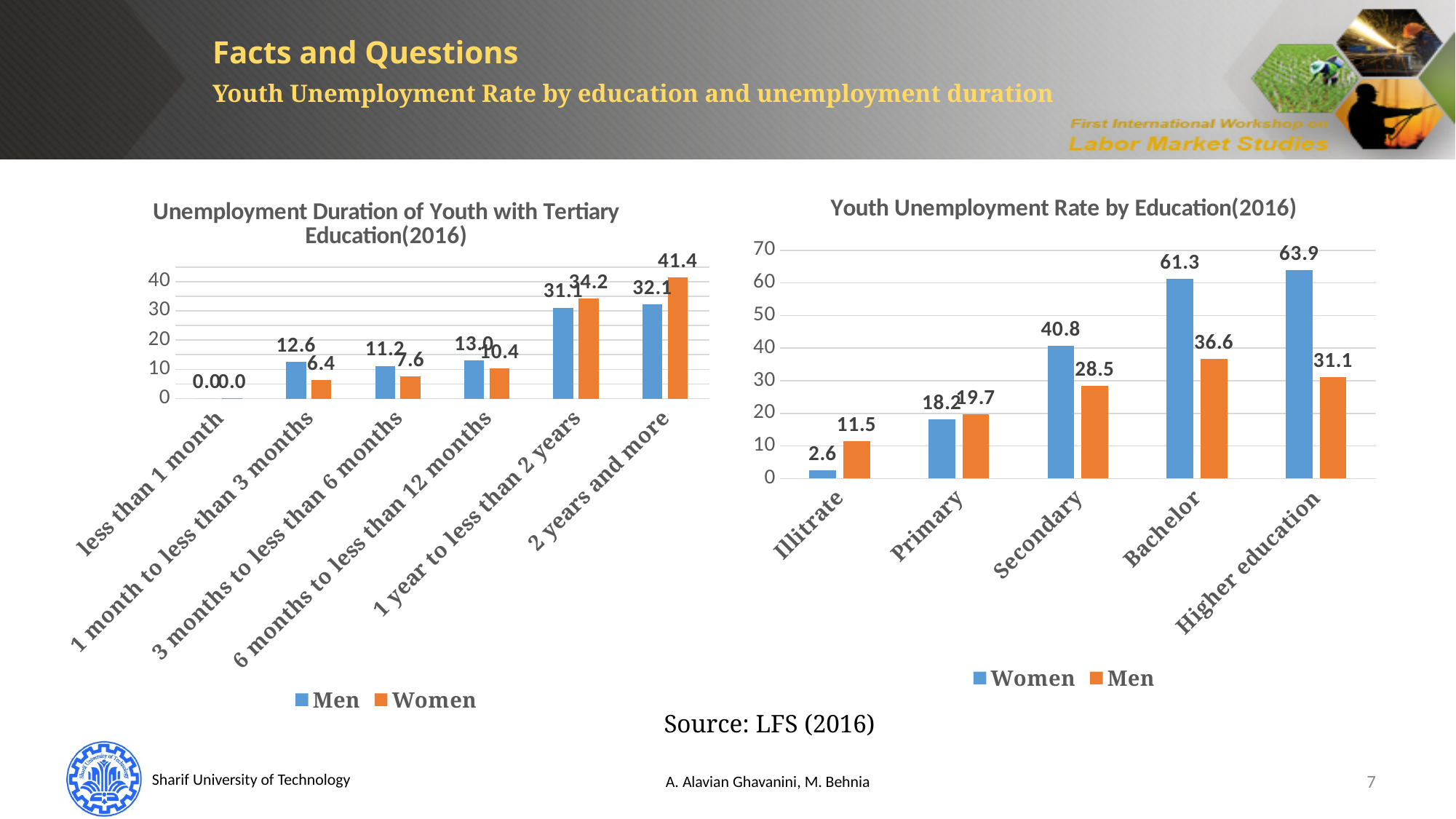
In the 'Unemployment Duration of Youth with Tertiary Education(2016)' chart, what is the value for Women in the '2 years and more' category? 41.4 In the 'Youth Unemployment Rate by Education(2016)' chart, what is the value for Men in the Secondary category? 28.5 In the 'Unemployment Duration of Youth with Tertiary Education(2016)' chart, which is larger for '1 year to less than 2 years': Men or Women? Women How many series does the legend of the 'Unemployment Duration of Youth with Tertiary Education(2016)' chart list? 2 In the 'Youth Unemployment Rate by Education(2016)' chart, which education category has the highest value for Women? Higher education In the 'Youth Unemployment Rate by Education(2016)' chart, what is the value for Women in the Bachelor category? 61.3 In the 'Unemployment Duration of Youth with Tertiary Education(2016)' chart, what is the difference between the Men and Women values for '3 months to less than 6 months'? 3.6 In the 'Youth Unemployment Rate by Education(2016)' chart, what is the difference between the Women and Men values for Higher education? 32.8 In the 'Youth Unemployment Rate by Education(2016)' chart, which education category has the lowest value for Men? Illitrate What type of chart is the 'Youth Unemployment Rate by Education(2016)' chart? Bar chart In the 'Unemployment Duration of Youth with Tertiary Education(2016)' chart, what is the value for Men in the '1 month to less than 3 months' category? 12.6 In the 'Youth Unemployment Rate by Education(2016)' chart, how many education categories are shown? 5